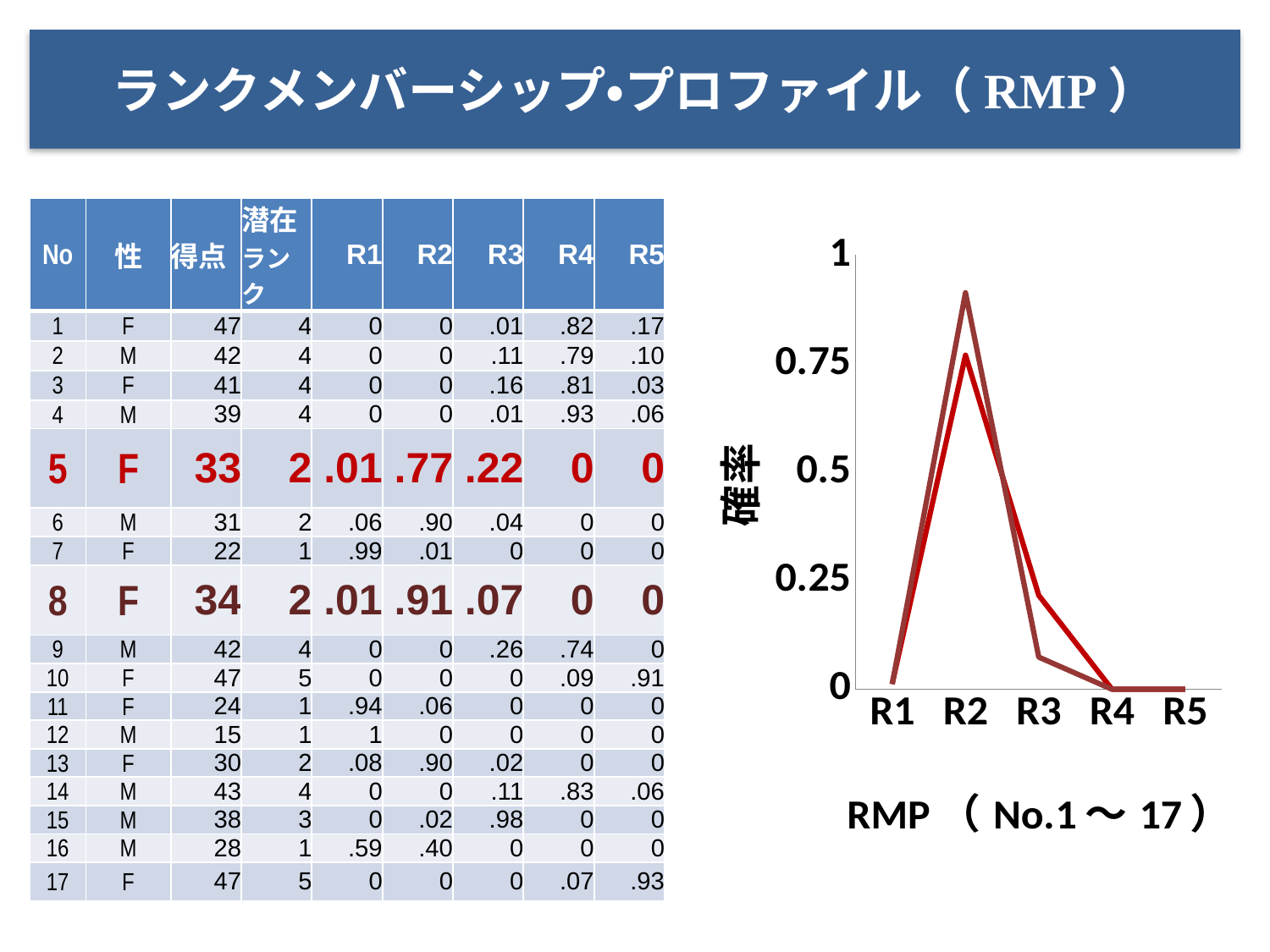
What caption appears below the chart? RMP（No.1～17） Is the value of the darker (brown) line at R2 greater or less than 0.75? greater Is the value of the bright red line at R3 greater or less than 0.5? less Is the value of the bright red line at R2 greater or less than 0.5? greater How many categories are shown on the x axis of the chart? 5 What is the label on the y axis of the chart? 確率 How many lines are plotted on the chart? 2 At which x-axis category do the plotted lines reach their highest value? R2 What kind of chart is shown on the right of the slide? line chart Which is larger for the bright red line, the value at R2 or the value at R3? R2 Do the plotted values rise or fall from R2 to R5? fall